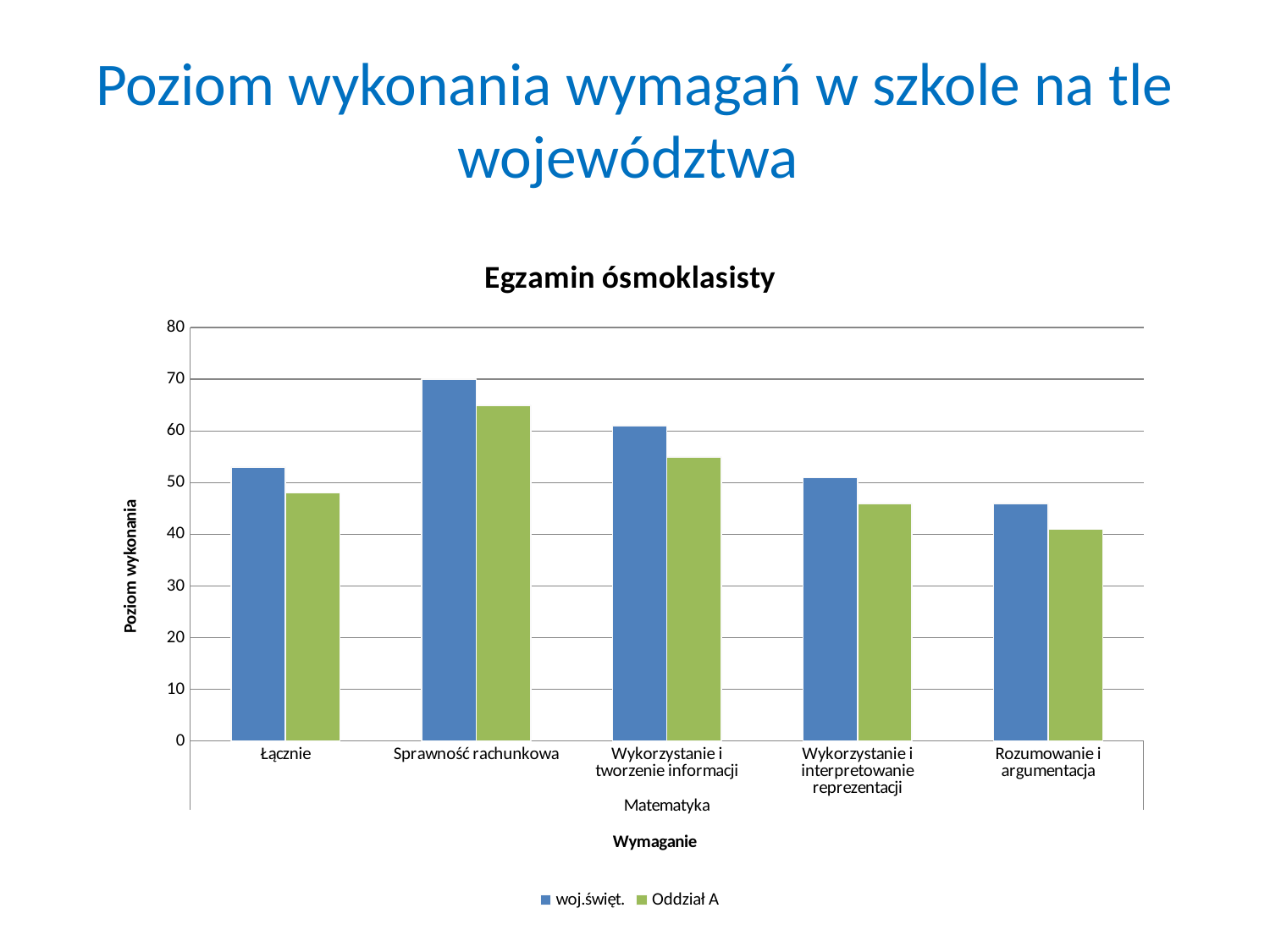
How many series does the chart legend list? 2 How many categories are shown on the x axis of the chart? 5 What kind of chart is shown on the slide? bar chart Is the Oddział A value for Sprawność rachunkowa greater or less than 60? greater Which category has the lowest value for the Oddział A series? Rozumowanie i argumentacja For Łącznie, which series has the larger value, woj.świet. or Oddział A? woj.świet. Is the woj.świet. value for Wykorzystanie i tworzenie informacji greater or less than 50? greater Which category has the highest value for the woj.świet. series? Sprawność rachunkowa Is the Oddział A value for Rozumowanie i argumentacja greater or less than 50? less Do the Oddział A values rise or fall from Sprawność rachunkowa to Rozumowanie i argumentacja? fall What is the title of the chart? Egzamin ósmoklasisty